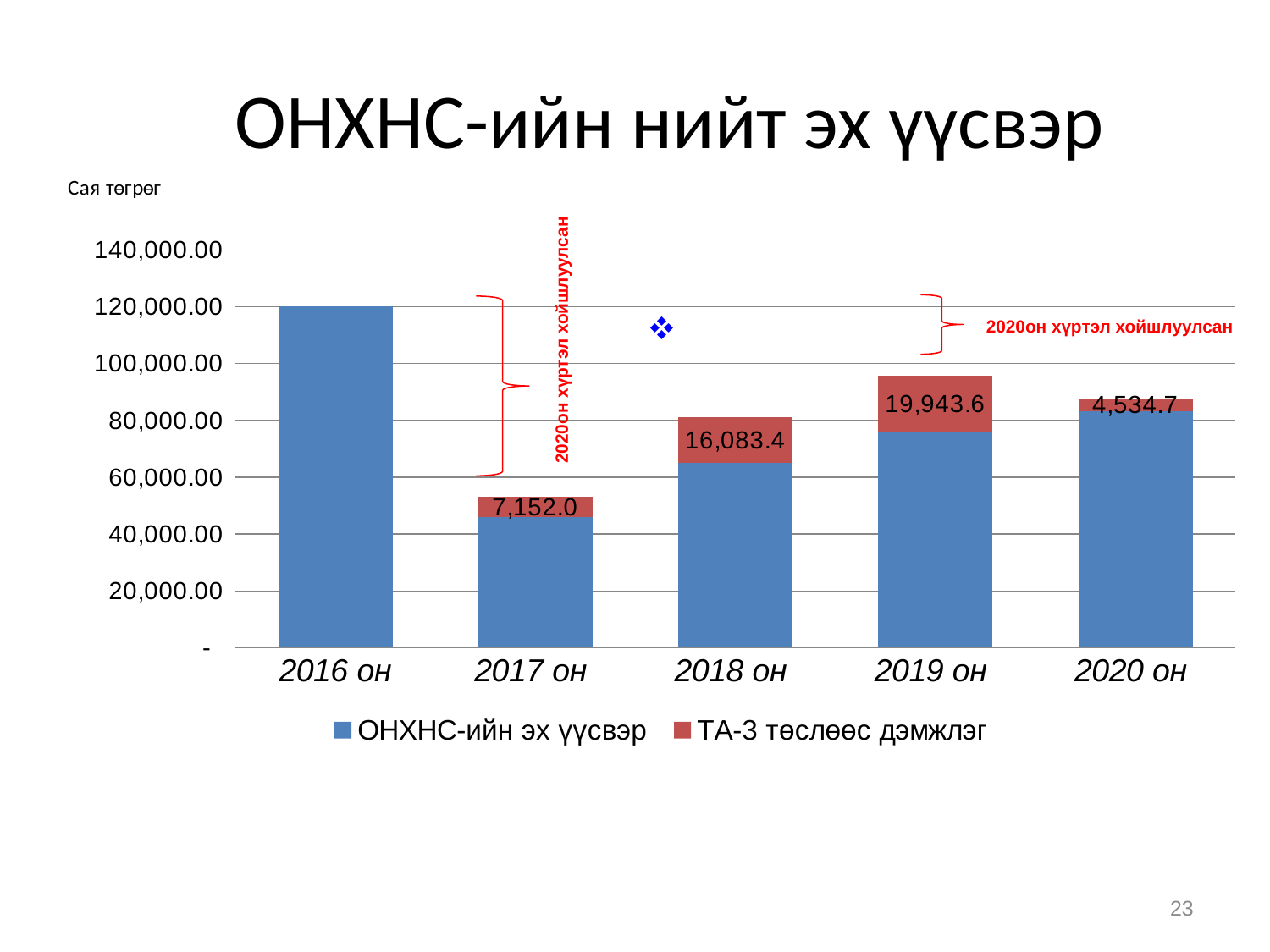
How many years are shown on the x axis? 5 Is the total height of the 2016 он bar greater or less than 100,000.00? greater What is the value of ТА-3 төслөөс дэмжлэг for 2018 он? 16,083.4 In which year is the ТА-3 төслөөс дэмжлэг value the highest? 2019 он What is the difference between the ТА-3 төслөөс дэмжлэг values for 2019 он and 2018 он? 3,860.2 What kind of chart is shown on the slide? bar chart Among the years with a labelled ТА-3 төслөөс дэмжлэг value, which year has the lowest? 2020 он Which year has the larger ТА-3 төслөөс дэмжлэг value, 2017 он or 2018 он? 2018 он How many series does the legend list? 2 What is the value of ТА-3 төслөөс дэмжлэг for 2017 он? 7,152.0 What is the value of ТА-3 төслөөс дэмжлэг for 2020 он? 4,534.7 What is the value of ТА-3 төслөөс дэмжлэг for 2019 он? 19,943.6